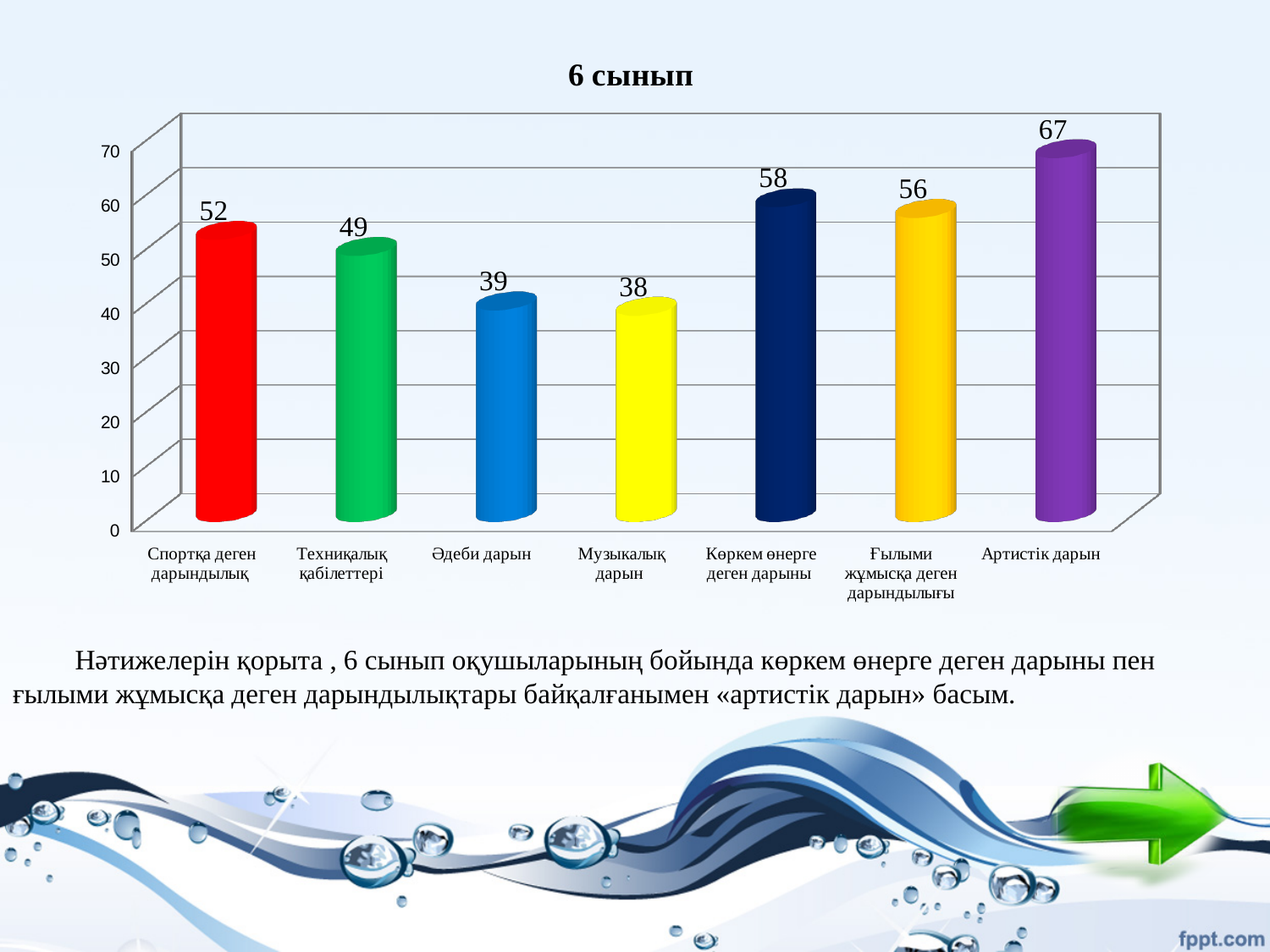
Which category has the lowest value? Музыкалық дарын What is the value for Музыкалық дарын? 38 Which is larger, the value for Көркем өнерге деген дарыны or the value for Ғылыми жұмысқа деген дарындылығы? Көркем өнерге деген дарыны What kind of chart is shown on the slide? bar chart Which category has the highest value? Артистік дарын What is the difference between the values for Артистік дарын and Спортқа деген дарындылық? 15 What is the value for Көркем өнерге деген дарыны? 58 How many categories are shown in the chart? 7 Is the value for Техникалық қабілеттері greater or less than 40? greater What colour is the bar for Әдеби дарын? blue What is the title of the chart? 6 сынып What is the value for Артистік дарын? 67